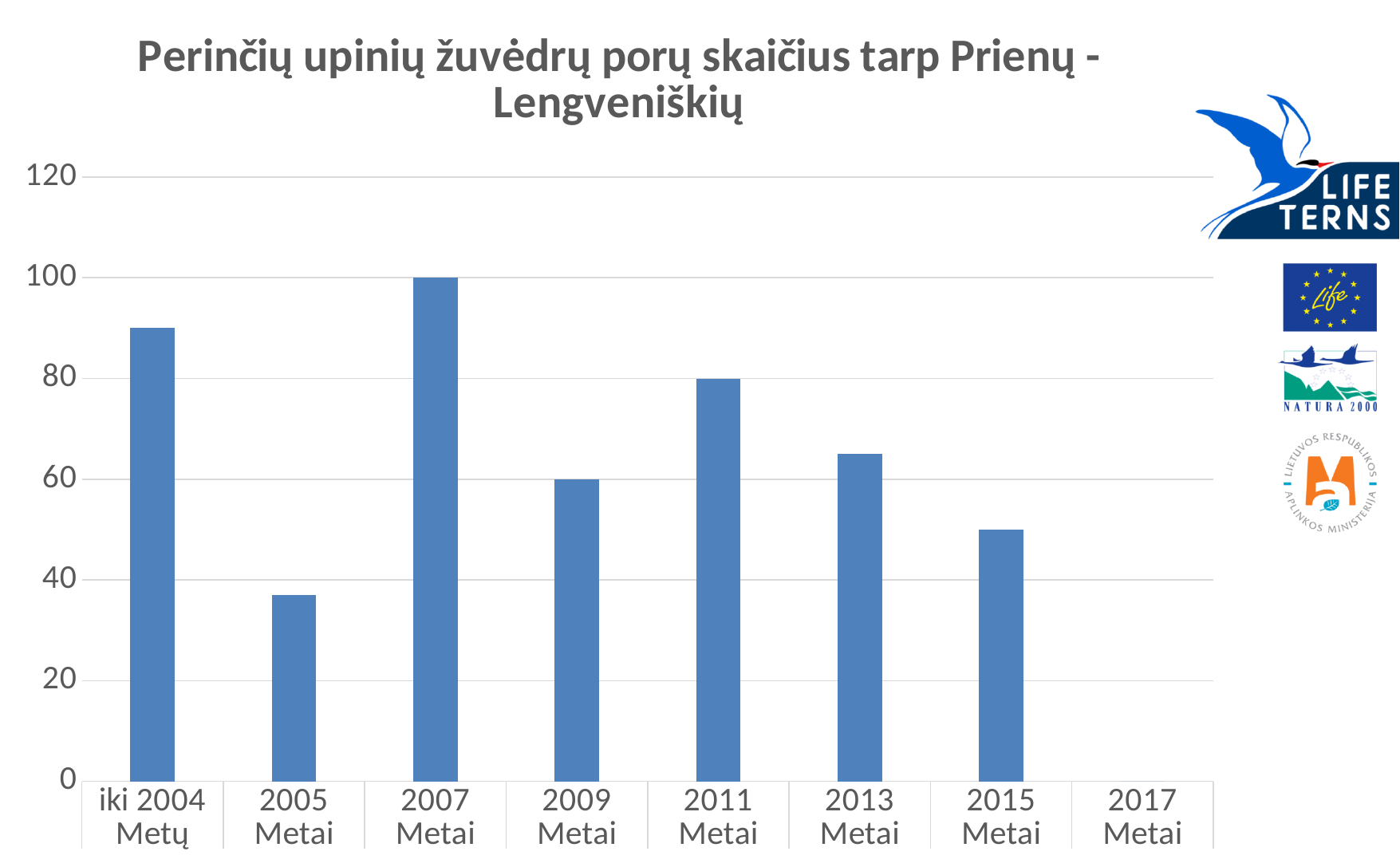
What kind of chart is shown on the slide? bar chart What is the value for 2009 Metai? 60 Is the value for iki 2004 Metų greater or less than 80? greater What is the title of the chart? Perinčių upinių žuvėdrų porų skaičius tarp Prienų - Lengveniškių Which category has the highest value? 2007 Metai What is the difference between the values for 2007 Metai and 2009 Metai? 40 What is the value for 2007 Metai? 100 Do the values rise or fall from 2007 Metai to 2015 Metai? fall Which is larger, the value for 2011 Metai or the value for 2013 Metai? 2011 Metai How many categories are shown on the x axis? 8 Is the value for 2005 Metai greater or less than 40? less What is the value for 2011 Metai? 80